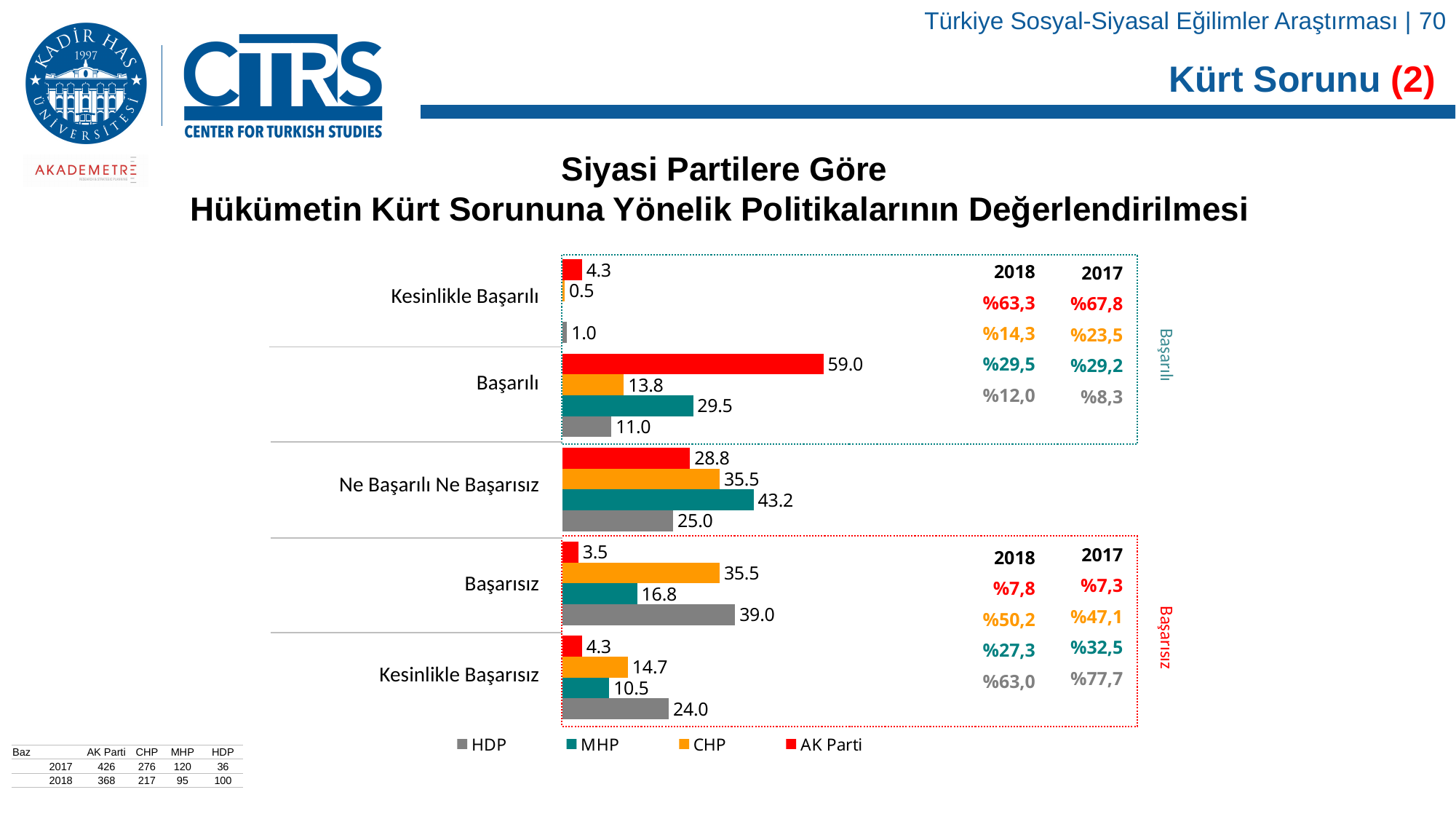
Which party has the lowest value in the Başarısız category? AK Parti How many series does the legend list? 4 What is the value for HDP in the Başarısız category? 39.0 What is the value for MHP in the Ne Başarılı Ne Başarısız category? 43.2 How many response categories are shown on the chart? 5 Which party has the highest value in the Başarılı category? AK Parti What is the difference between the HDP and MHP values in the Kesinlikle Başarısız category? 13.5 In the Ne Başarılı Ne Başarısız category, which is larger: the CHP value or the AK Parti value? CHP What kind of chart is shown on the slide? Bar chart What is the value for CHP in the Kesinlikle Başarısız category? 14.7 Which colour represents HDP in the chart? Gray What is the value for AK Parti in the Başarılı category? 59.0